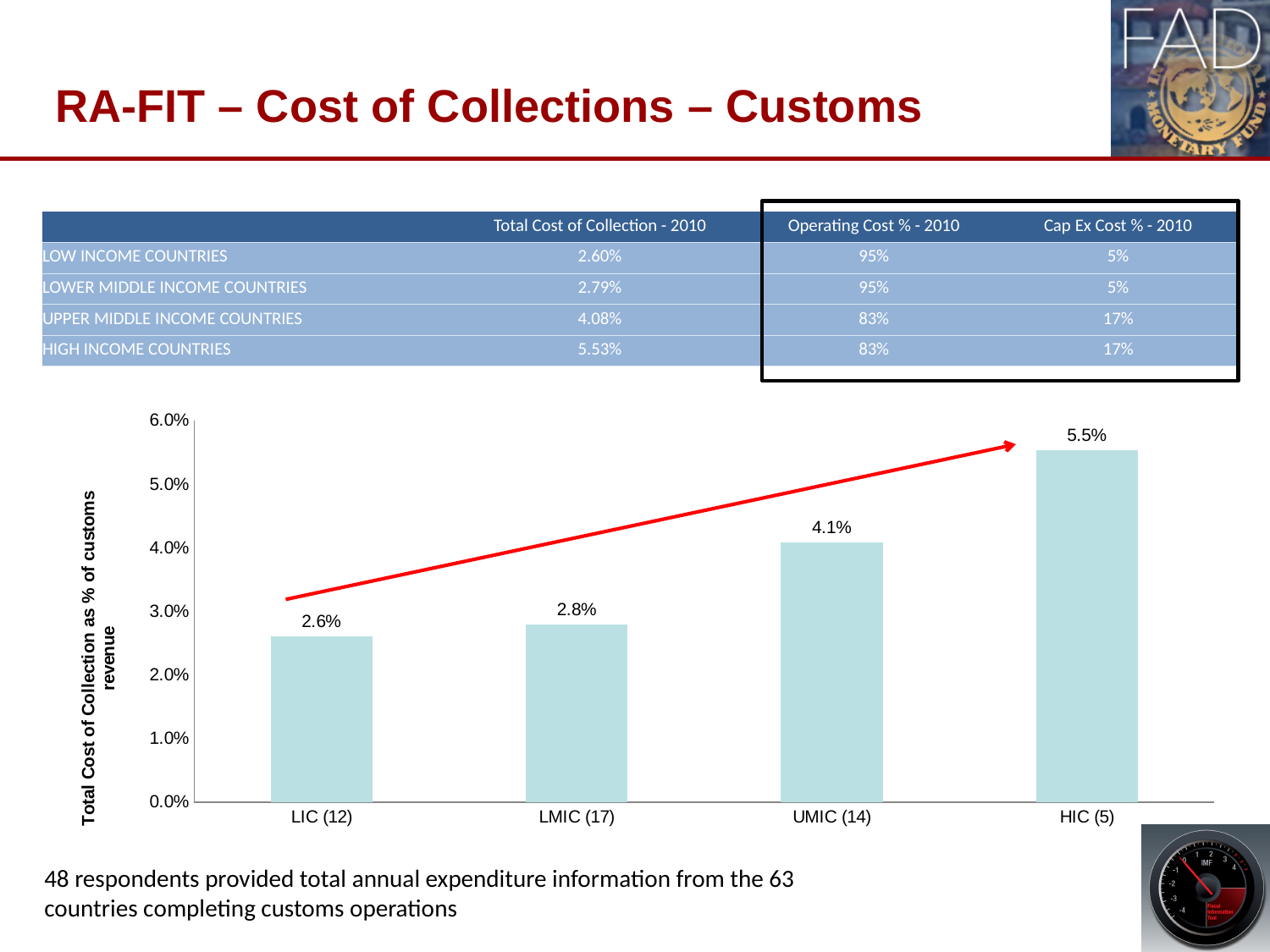
Which category has the lowest value in the bar chart? LIC (12) What is the value for UMIC (14) in the bar chart? 4.1% What is the difference between the values for UMIC (14) and LMIC (17) in the bar chart? 1.3% How many categories are shown on the x axis of the bar chart? 4 Which category has the highest value in the bar chart? HIC (5) What is the value for HIC (5) in the bar chart? 5.5% What is the value for LIC (12) in the bar chart? 2.6% Is the value for HIC (5) in the bar chart greater or less than 5.0%? greater What kind of chart is shown on the slide? bar chart Do the values in the bar chart rise or fall from LIC (12) to HIC (5)? rise Which is larger in the bar chart, the value for UMIC (14) or the value for LMIC (17)? UMIC (14) What is the difference between the values for HIC (5) and LIC (12) in the bar chart? 2.9%